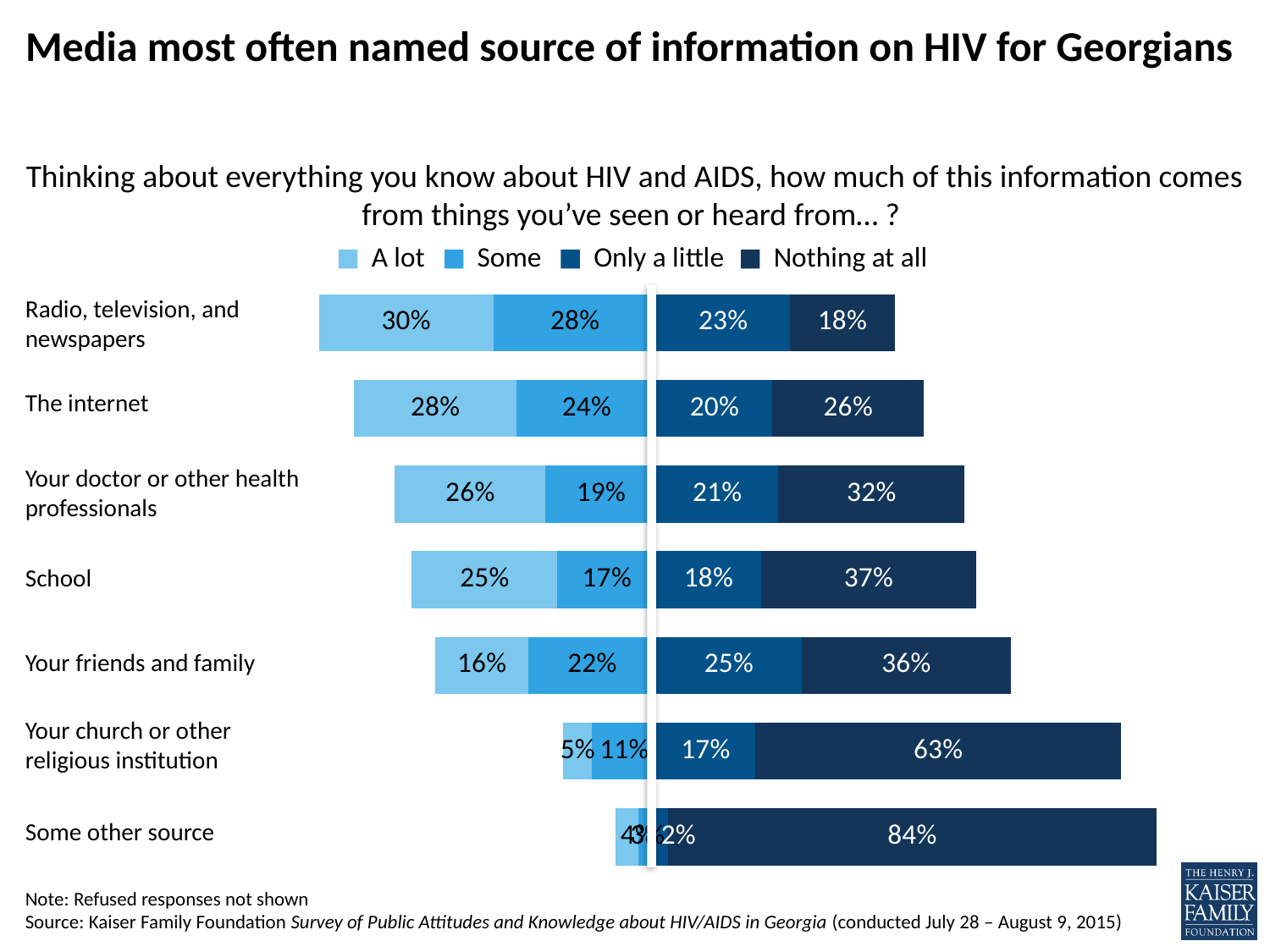
Which source has the highest 'Nothing at all' percentage? Some other source What percentage say 'Only a little' of their HIV information comes from their friends and family? 25% What is the combined percentage of 'A lot' and 'Some' responses for radio, television, and newspapers? 58% What is the difference between the 'Nothing at all' percentages for school and for the internet? 11% How many series does the legend list? 4 What percentage of Georgians say 'A lot' of their HIV information comes from radio, television, and newspapers? 30% What percentage say 'Some' of their HIV information comes from school? 17% What kind of chart is shown on the slide? stacked bar chart What percentage say 'Nothing at all' of their HIV information comes from their church or other religious institution? 63% Which source has the highest 'A lot' percentage? Radio, television, and newspapers Which is larger: the 'A lot' percentage for the internet or for your doctor or other health professionals? The internet How many information sources (categories) are plotted in the chart? 7